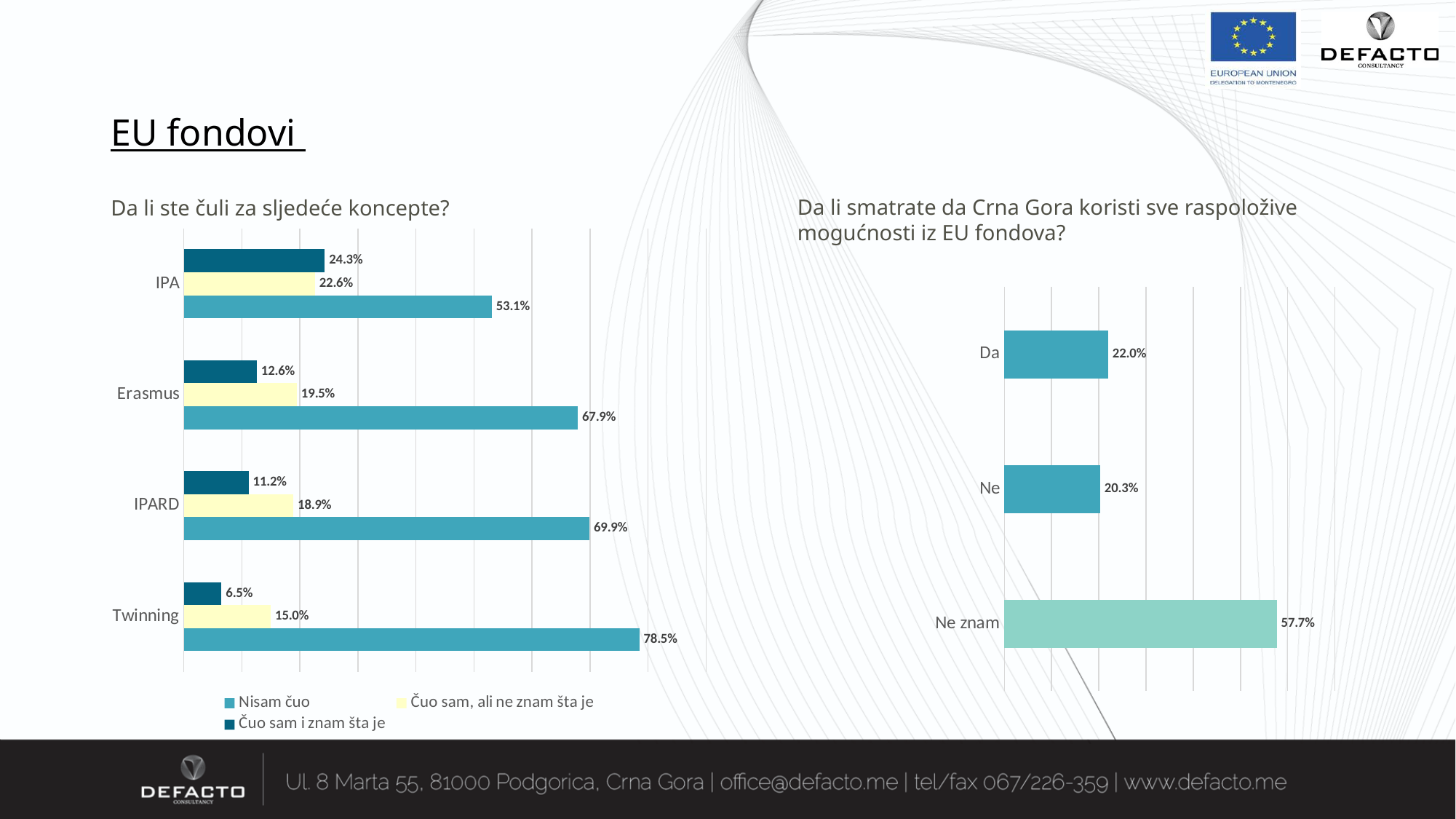
In the chart 'Da li ste čuli za sljedeće koncepte?', what is the difference between the 'Nisam čuo' values for IPARD and IPA? 16.8% In the chart 'Da li ste čuli za sljedeće koncepte?', what is the 'Nisam čuo' value for Twinning? 78.5% In the chart 'Da li smatrate da Crna Gora koristi sve raspoložive mogućnosti iz EU fondova?', what is the value for 'Ne znam'? 57.7% In the chart 'Da li ste čuli za sljedeće koncepte?', how many series does the legend list? 3 In the chart 'Da li ste čuli za sljedeće koncepte?', what is the 'Čuo sam i znam šta je' value for IPA? 24.3% In the chart 'Da li smatrate da Crna Gora koristi sve raspoložive mogućnosti iz EU fondova?', which answer has the highest value? Ne znam In the chart 'Da li ste čuli za sljedeće koncepte?', what is the 'Čuo sam, ali ne znam šta je' value for Erasmus? 19.5% What kind of chart is 'Da li smatrate da Crna Gora koristi sve raspoložive mogućnosti iz EU fondova?'? Bar chart In the chart 'Da li smatrate da Crna Gora koristi sve raspoložive mogućnosti iz EU fondova?', what is the difference between 'Da' and 'Ne'? 1.7% In the chart 'Da li ste čuli za sljedeće koncepte?', how many concepts are shown? 4 In the chart 'Da li ste čuli za sljedeće koncepte?', which concept has the lowest 'Čuo sam i znam šta je' value? Twinning In the chart 'Da li ste čuli za sljedeće koncepte?', which concept has the highest 'Nisam čuo' value? Twinning